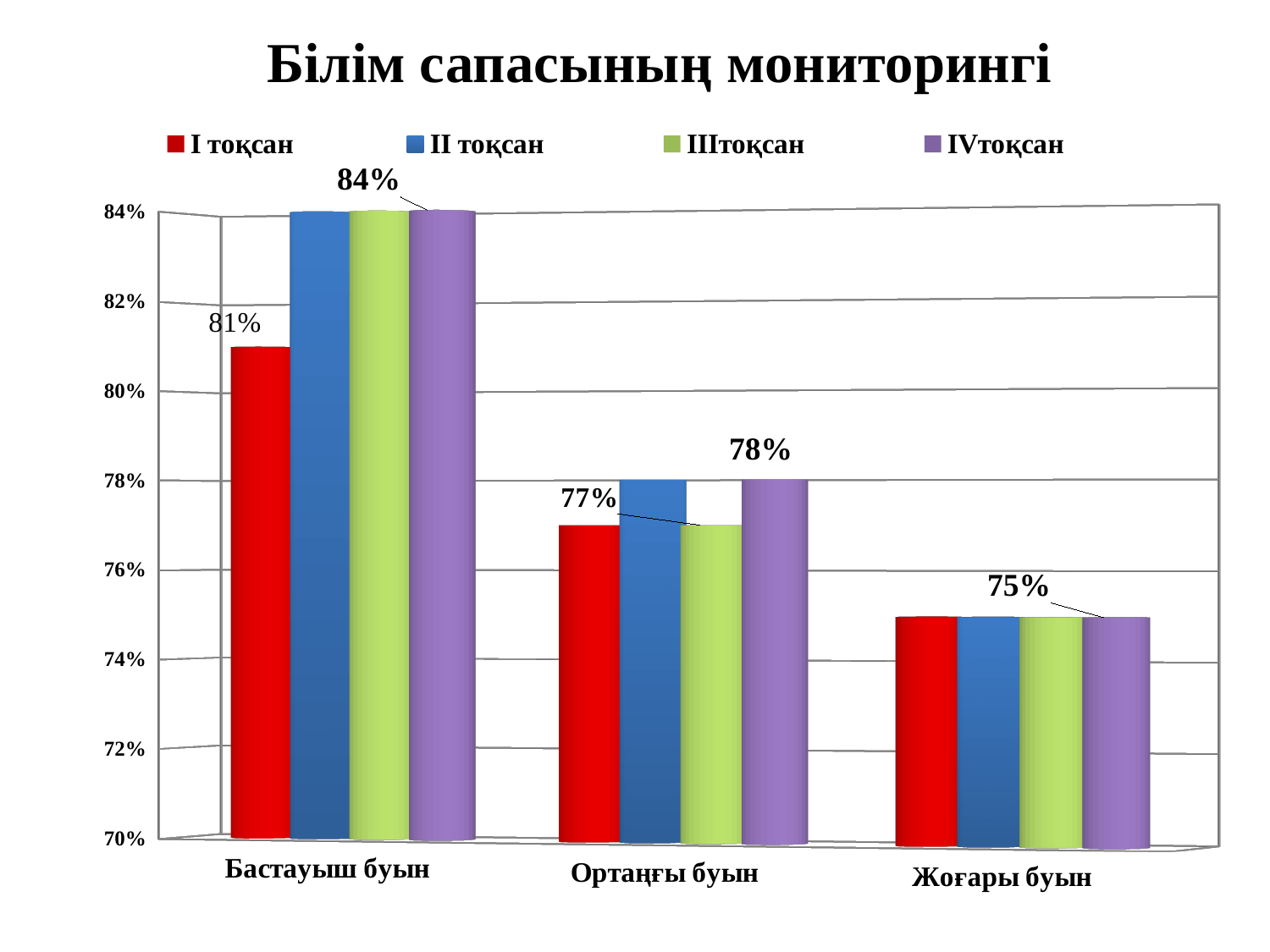
What is the value for IVтоқсан in the Жоғары буын category? 75% Is the value for I тоқсан in the Жоғары буын category greater or less than 76%? less How many categories are shown on the x axis? 3 What is the value for IVтоқсан in the Бастауыш буын category? 84% Which category has the lowest IVтоқсан value? Жоғары буын Which category has the highest IVтоқсан value? Бастауыш буын What is the value for IVтоқсан in the Ортаңғы буын category? 78% What is the difference between the IVтоқсан values for Бастауыш буын and Ортаңғы буын? 6% What is the value for I тоқсан in the Бастауыш буын category? 81% How many series does the legend list? 4 What is the value for IIIтоқсан in the Ортаңғы буын category? 77% Do the IVтоқсан values rise or fall from Бастауыш буын to Жоғары буын? fall